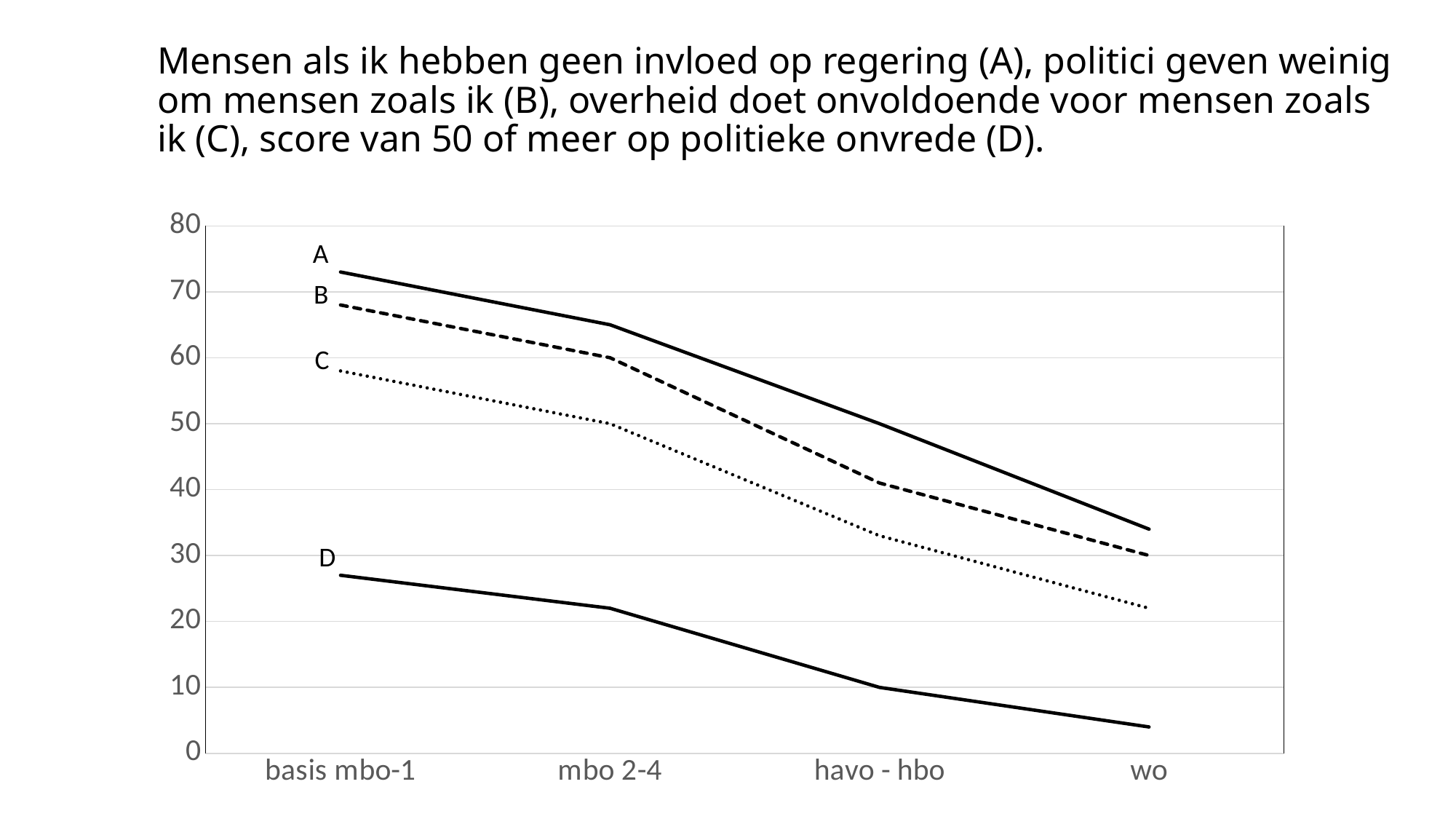
How many education categories are shown on the x axis? 4 Do the values of line A rise or fall from basis mbo-1 to wo? fall Is the value for line A at wo greater or less than 30? greater What kind of chart is shown on the slide? line chart How many lines (series) are plotted on the chart? 4 What is the value for line D at havo - hbo? 10 Which line has the highest value at basis mbo-1? A At wo, which line has the larger value, A or B? A Which line has the lowest values across all categories? D Is the value for line C at wo greater or less than 30? less Is the value for line D at wo greater or less than 10? less